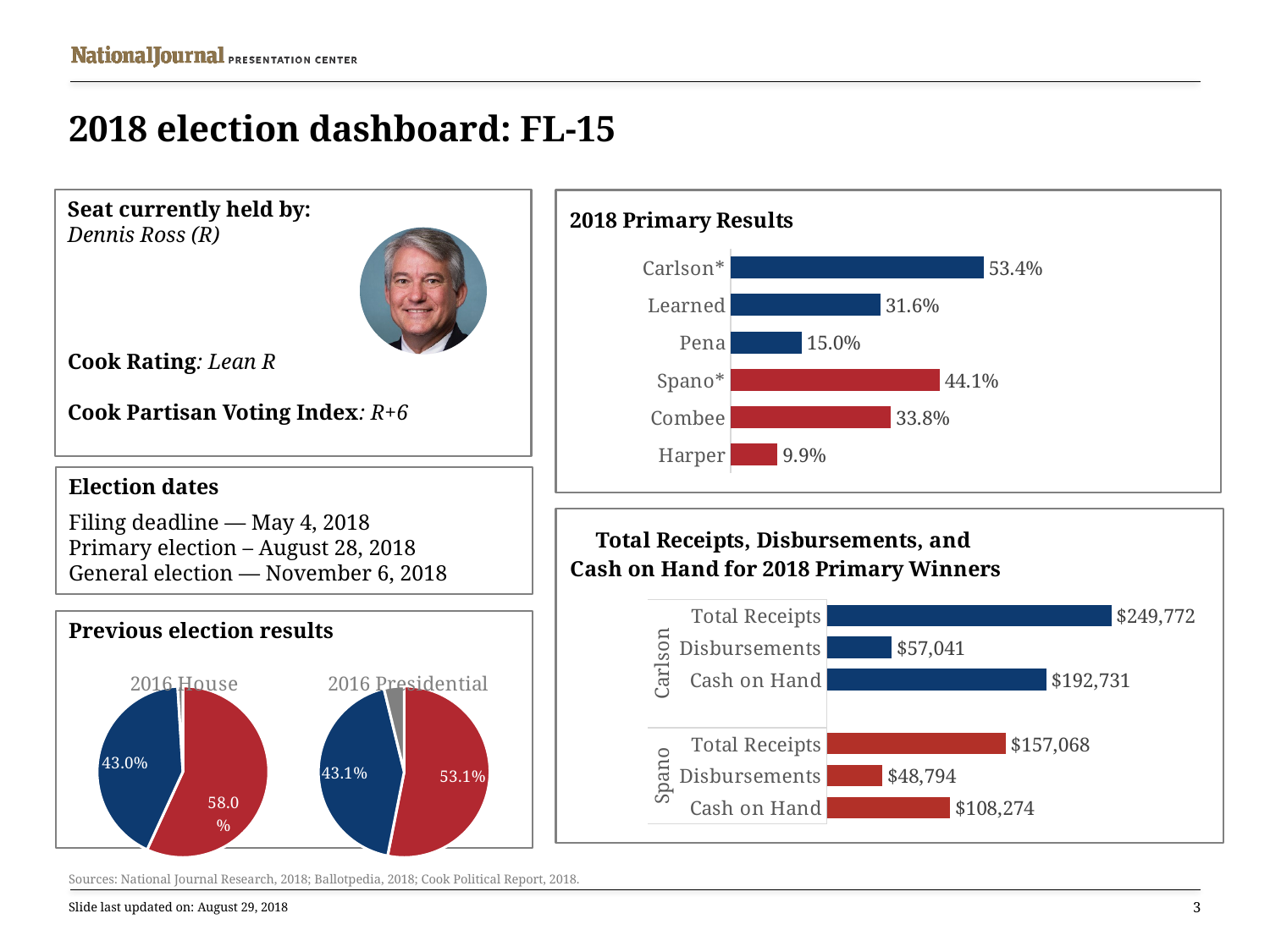
In the 2018 Primary Results chart, what percentage did Carlson* receive? 53.4% In the Total Receipts, Disbursements, and Cash on Hand chart, what is Carlson's Cash on Hand? $192,731 In the Total Receipts, Disbursements, and Cash on Hand chart, who has the larger Total Receipts, Carlson or Spano? Carlson In the 2018 Primary Results chart, what is the difference in percentage points between Spano* and Combee? 10.3 What type of chart is the 2018 Primary Results chart? Bar chart In the Total Receipts, Disbursements, and Cash on Hand chart, what are Spano's Disbursements? $48,794 In the 2018 Primary Results chart, which candidate has the highest percentage? Carlson* In the 2018 Primary Results chart, what percentage did Harper receive? 9.9% In the Total Receipts, Disbursements, and Cash on Hand chart, what is the difference between Carlson's and Spano's Total Receipts? $92,704 In the 2016 Presidential pie chart under Previous election results, what share does the red slice represent? 53.1% In the 2018 Primary Results chart, how many candidates are shown? 6 In the 2018 Primary Results chart, which candidate has the lowest percentage? Harper